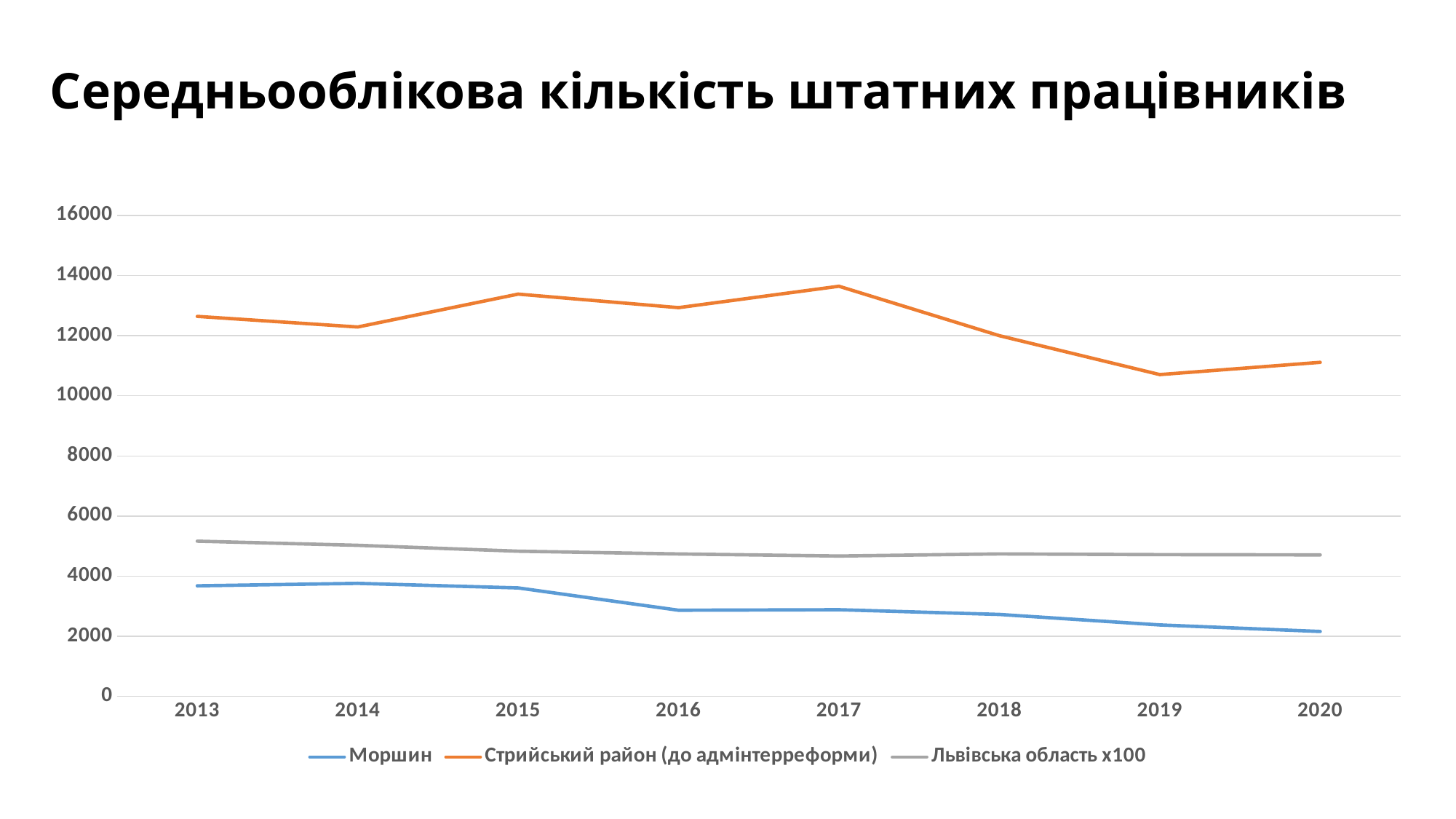
How many years are plotted along the x axis? 8 How many series does the legend list? 3 In which year is the value for Стрийський район (до адмінтерреформи) highest? 2017 In which year is the value for Стрийський район (до адмінтерреформи) lowest? 2019 In which year is the value for Моршин lowest? 2020 What is the title of the chart? Середньооблікова кількість штатних працівників In which year is the value for Львівська область x100 highest? 2013 Which series is drawn in orange? Стрийський район (до адмінтерреформи) Does the value for Моршин rise or fall from 2015 to 2020? fall Is the value for Стрийський район (до адмінтерреформи) in 2019 greater or less than 12000? less What kind of chart is shown on the slide? line chart Is the value for Моршин in 2020 greater or less than 4000? less